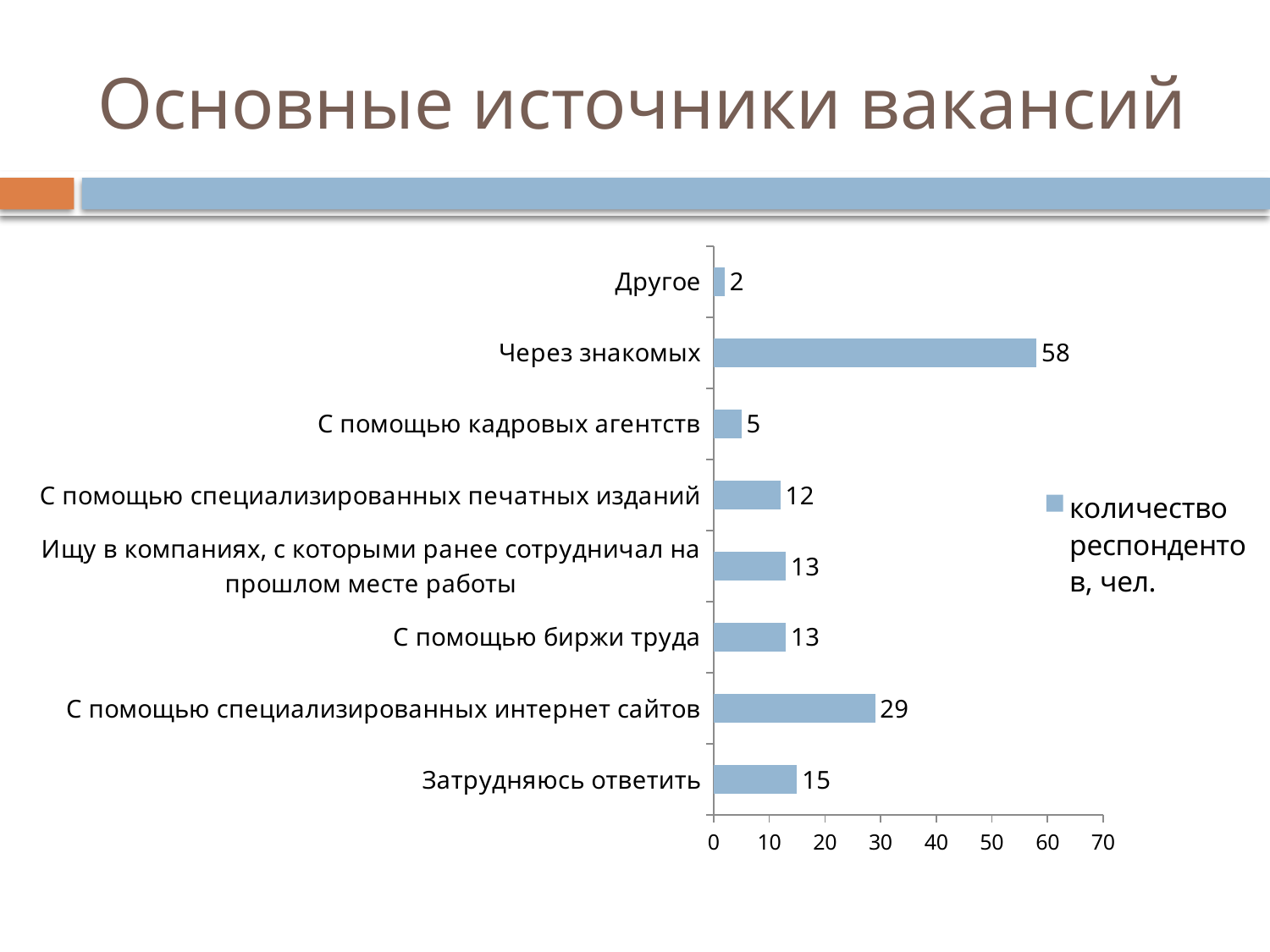
What is the value for "С помощью специализированных интернет сайтов"? 29 Which is larger: the value for "С помощью специализированных печатных изданий" or the value for "Затрудняюсь ответить"? Затрудняюсь ответить What is the value for "Через знакомых"? 58 Which category has the highest value? Через знакомых What is the value for "С помощью кадровых агентств"? 5 Is the value for "Через знакомых" greater or less than 50? greater What kind of chart is shown on the slide? bar chart What is the difference between the values for "Через знакомых" and "С помощью специализированных интернет сайтов"? 29 Which category has the lowest value? Другое What is the value for "Затрудняюсь ответить"? 15 How many categories are shown in the chart? 8 What is the legend entry of the chart? количество респондентов, чел.